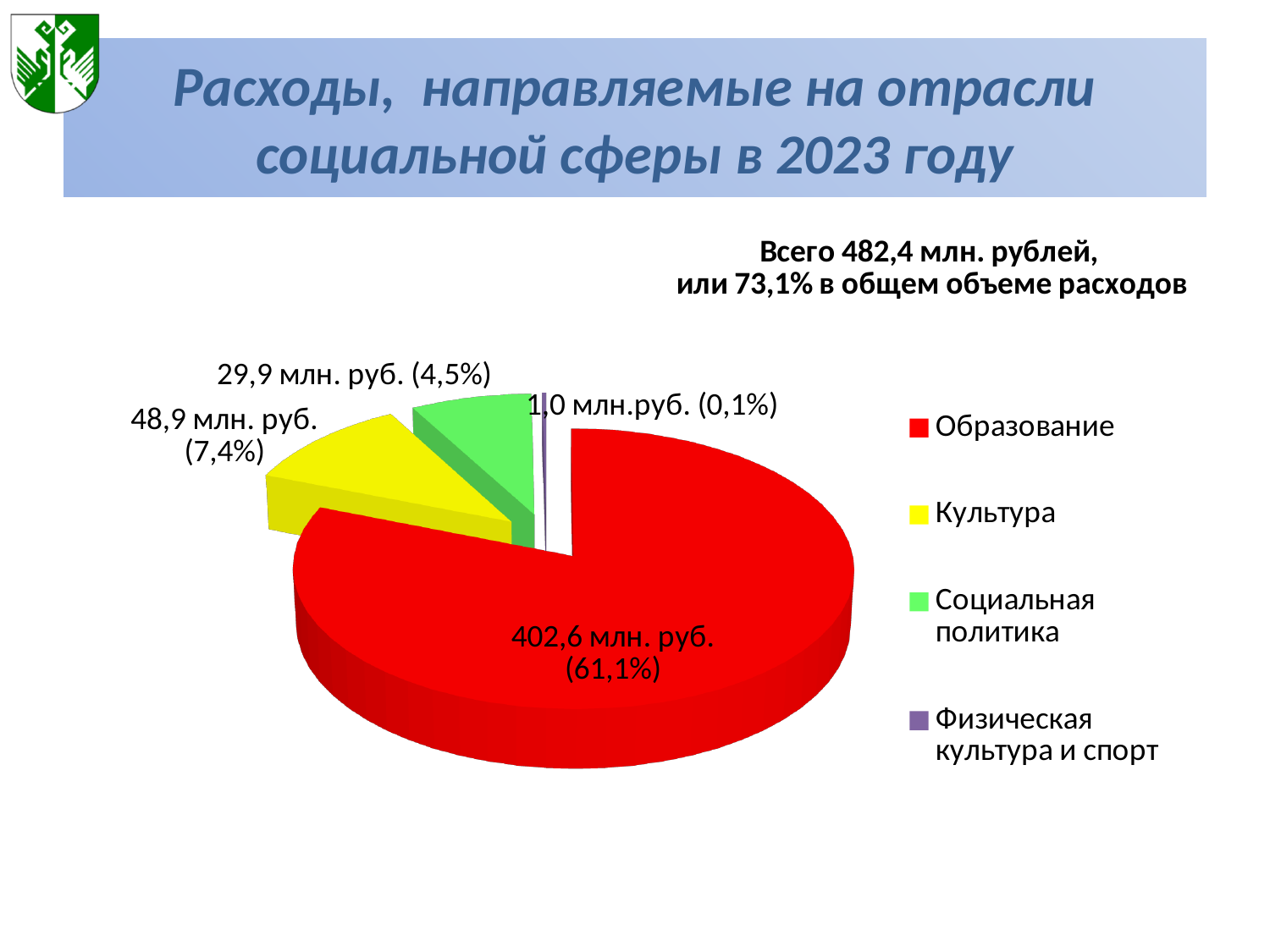
What percentage is printed next to the Культура slice? 7,4% How many categories does the legend of the pie chart list? 4 Which category has the largest slice of the pie? Образование What kind of chart is shown on the slide? Pie chart What value in млн. руб. is shown for Культура? 48,9 млн. руб. What percentage is printed next to the Образование slice? 61,1% What value in млн. руб. is shown for Социальная политика? 29,9 млн. руб. What is the difference in млн. руб. between Культура and Социальная политика? 19,0 млн. руб. Which colour represents Культура in the pie chart? Yellow What value in млн. руб. is shown for Физическая культура и спорт? 1,0 млн.руб. What value in млн. руб. is shown for Образование? 402,6 млн. руб. Which category has the smallest slice of the pie? Физическая культура и спорт